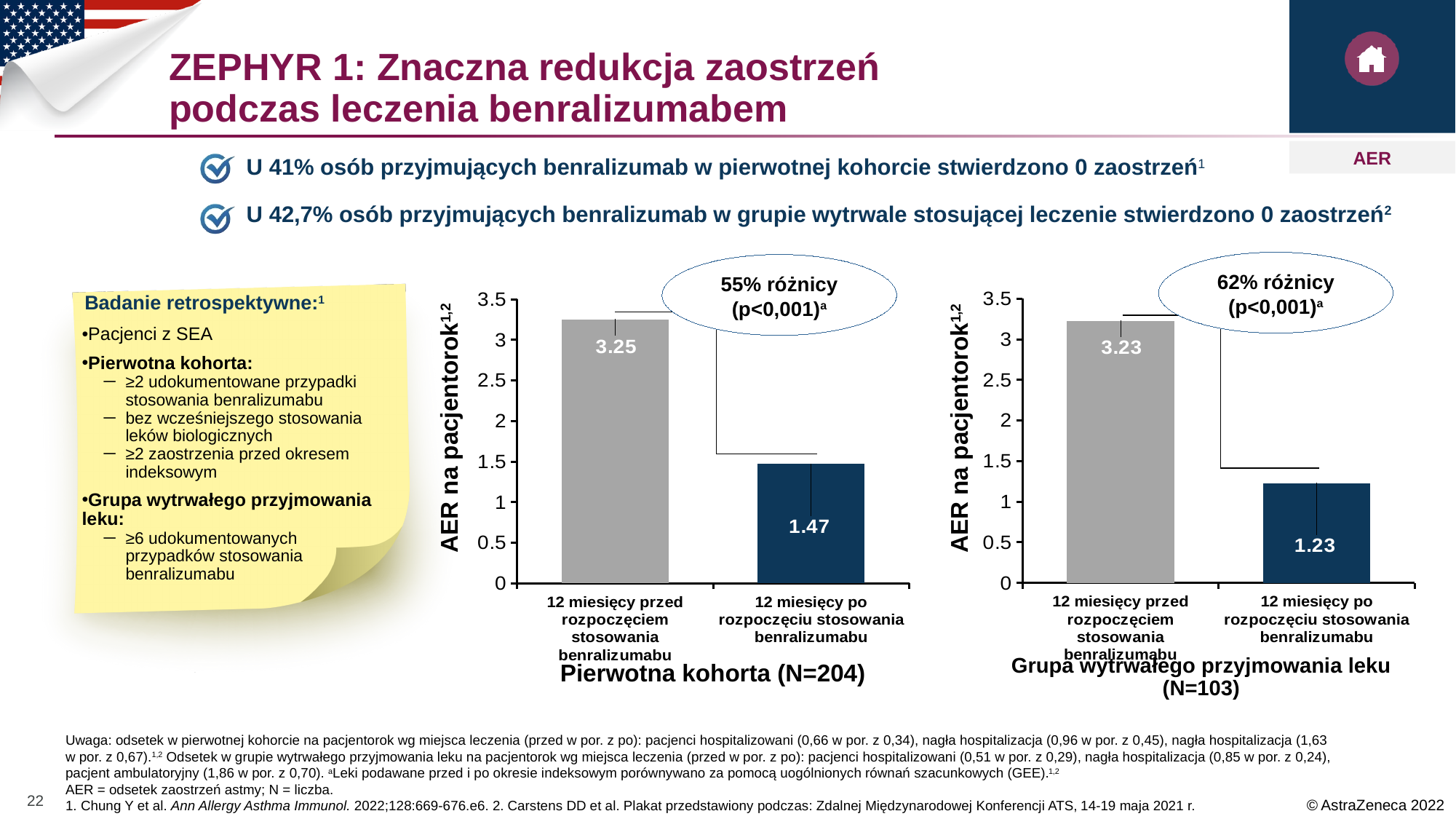
In the chart for Pierwotna kohorta (N=204), what is the difference between the AER before and after starting benralizumab? 1.78 In the chart for Pierwotna kohorta (N=204), what is the AER value for 12 miesięcy przed rozpoczęciem stosowania benralizumabu? 3.25 In the chart for Pierwotna kohorta (N=204), what is the AER value for 12 miesięcy po rozpoczęciu stosowania benralizumabu? 1.47 In the chart for Grupa wytrwałego przyjmowania leku (N=103), what is the difference between the AER before and after starting benralizumab? 2.00 In the chart for Grupa wytrwałego przyjmowania leku (N=103), what is the AER value for 12 miesięcy przed rozpoczęciem stosowania benralizumabu? 3.23 How many categories are shown in the chart for Grupa wytrwałego przyjmowania leku (N=103)? 2 Is the AER after starting benralizumab larger in the Pierwotna kohorta chart or in the Grupa wytrwałego przyjmowania leku chart? Pierwotna kohorta What type of chart is used for Pierwotna kohorta (N=204)? Bar chart In the chart for Pierwotna kohorta (N=204), which category has the higher AER? 12 miesięcy przed rozpoczęciem stosowania benralizumabu What percentage difference is annotated above the chart for Grupa wytrwałego przyjmowania leku (N=103)? 62% różnicy In the chart for Grupa wytrwałego przyjmowania leku (N=103), what is the AER value for 12 miesięcy po rozpoczęciu stosowania benralizumabu? 1.23 In the chart for Grupa wytrwałego przyjmowania leku (N=103), which category has the lowest AER? 12 miesięcy po rozpoczęciu stosowania benralizumabu